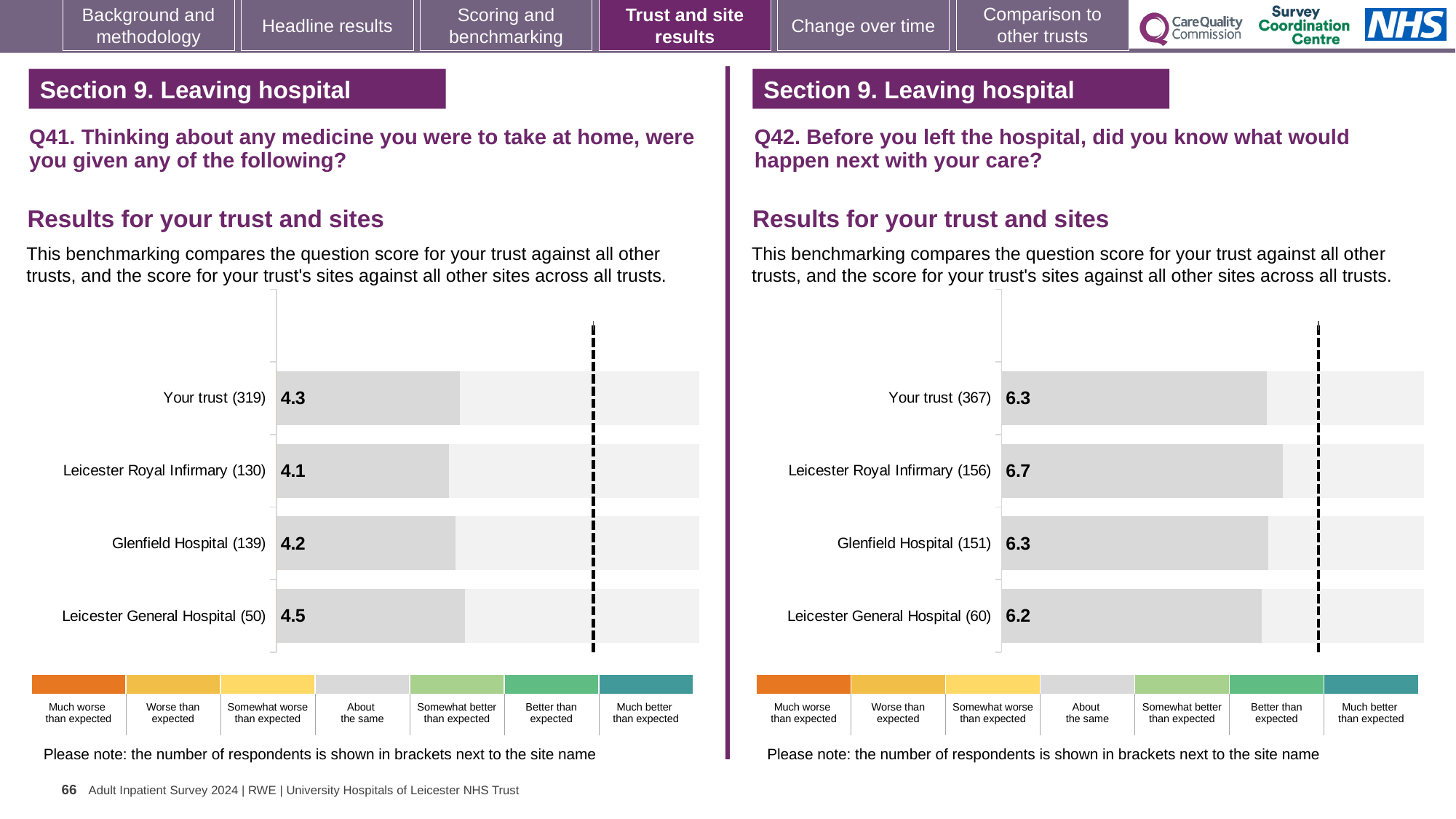
In the Q41 chart on the left, which site or trust has the highest score? Leicester General Hospital In the Q42 chart on the right, which site or trust has the highest score? Leicester Royal Infirmary In the Q42 chart on the right, what is the score for Leicester Royal Infirmary? 6.7 In the Q41 chart on the left, what is the score for Your trust? 4.3 What kind of chart is the Q42 chart on the right? Bar chart How many bars are shown in the Q41 chart on the left? 4 In the Q41 chart on the left, what is the score for Leicester General Hospital? 4.5 In the Q41 chart on the left, which site or trust has the lowest score? Leicester Royal Infirmary In the Q42 chart on the right, which has the larger score, Your trust or Leicester General Hospital? Your trust In the Q42 chart on the right, what is the difference between the scores for Leicester Royal Infirmary and Leicester General Hospital? 0.5 In the Q41 chart on the left, what is the difference between the scores for Leicester General Hospital and Leicester Royal Infirmary? 0.4 In the Q42 chart on the right, what is the score for Glenfield Hospital? 6.3